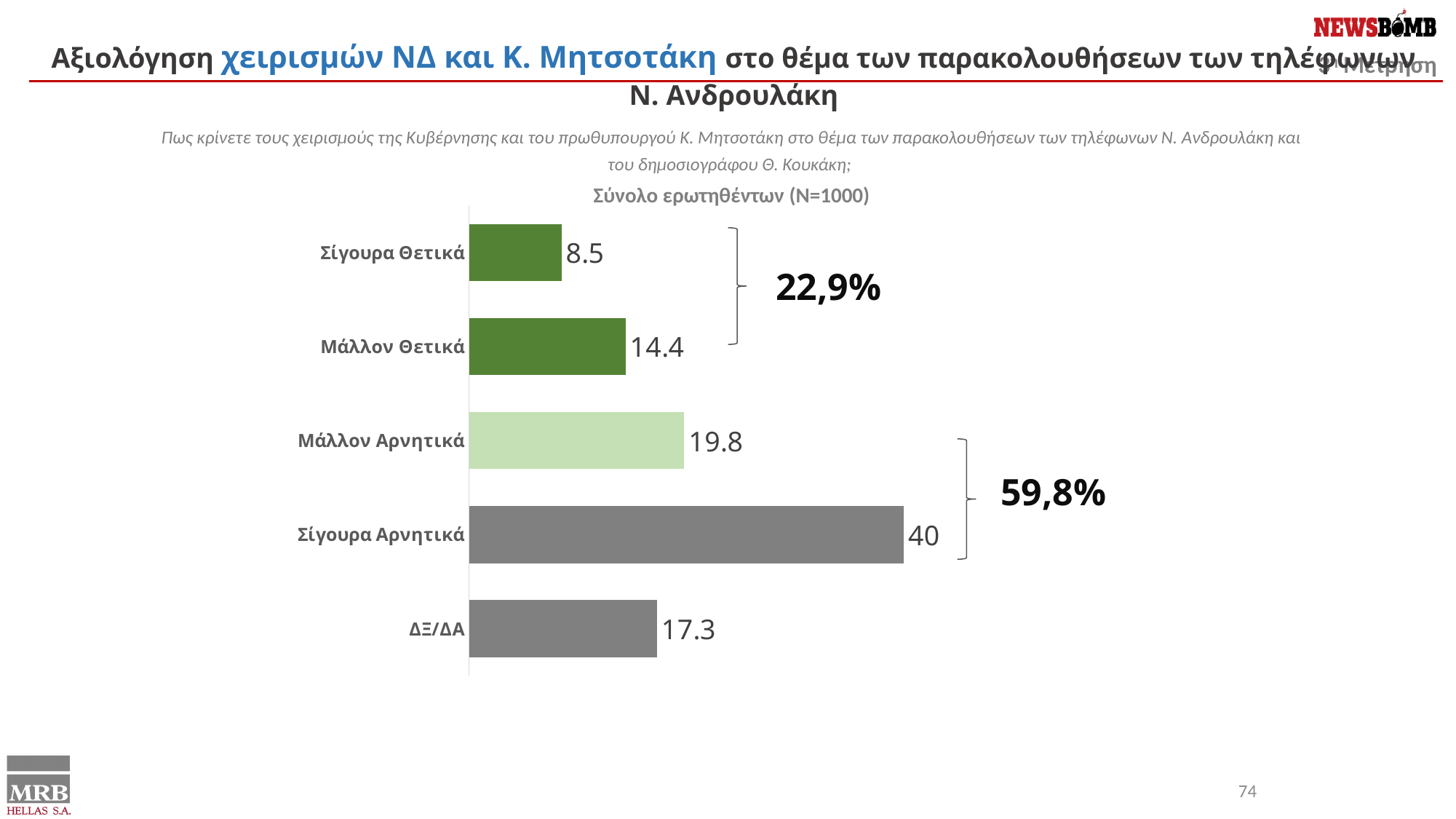
What is the value for Σίγουρα Θετικά? 8.5 What combined percentage is shown for the two negative categories (Μάλλον Αρνητικά and Σίγουρα Αρνητικά)? 59,8% Which category has the highest value? Σίγουρα Αρνητικά What is the difference between the values for Σίγουρα Αρνητικά and Μάλλον Αρνητικά? 20.2 What is the value for Σίγουρα Αρνητικά? 40 What kind of chart is shown on the slide? Bar chart What is the value for ΔΞ/ΔΑ? 17.3 What is the value for Μάλλον Θετικά? 14.4 What is the value for Μάλλον Αρνητικά? 19.8 Which category has the lowest value? Σίγουρα Θετικά How many categories are shown in the chart? 5 Which is larger, the value for Μάλλον Αρνητικά or the value for ΔΞ/ΔΑ? Μάλλον Αρνητικά